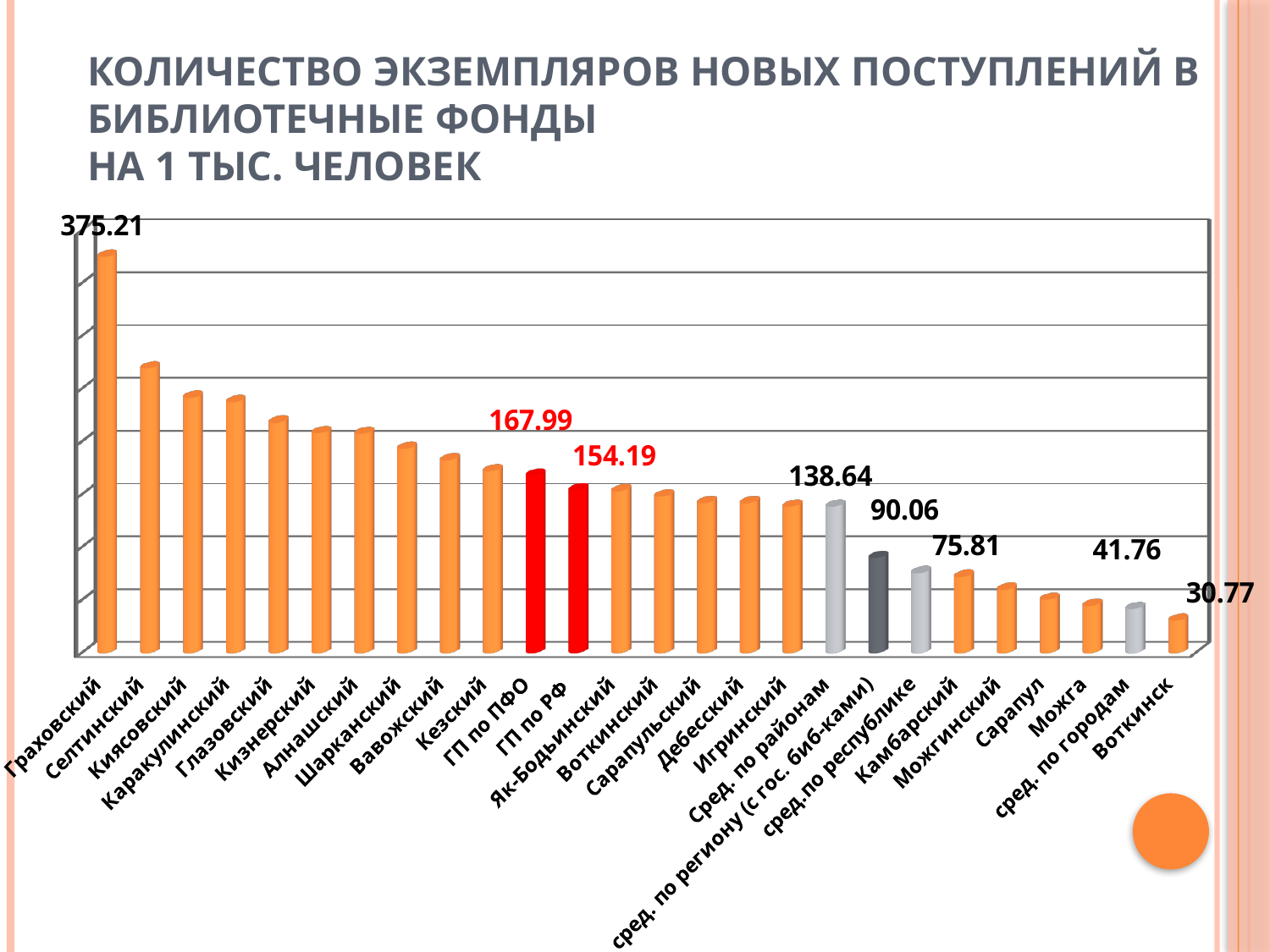
What is the difference between the values for ГП по ПФО and ГП по РФ? 13.80 What is the value for Граховский? 375.21 What is the value for Сред. по районам? 138.64 Which is larger, the value for Селтинский or the value for Камбарский? Селтинский What is the difference between the values for Граховский and Воткинск? 344.44 What is the value for сред. по городам? 41.76 What kind of chart is shown on the slide? Bar chart What is the value for ГП по РФ? 154.19 Which category has the highest value? Граховский How many bars are shown in the chart? 26 What is the value for ГП по ПФО? 167.99 Which category has the lowest value? Воткинск